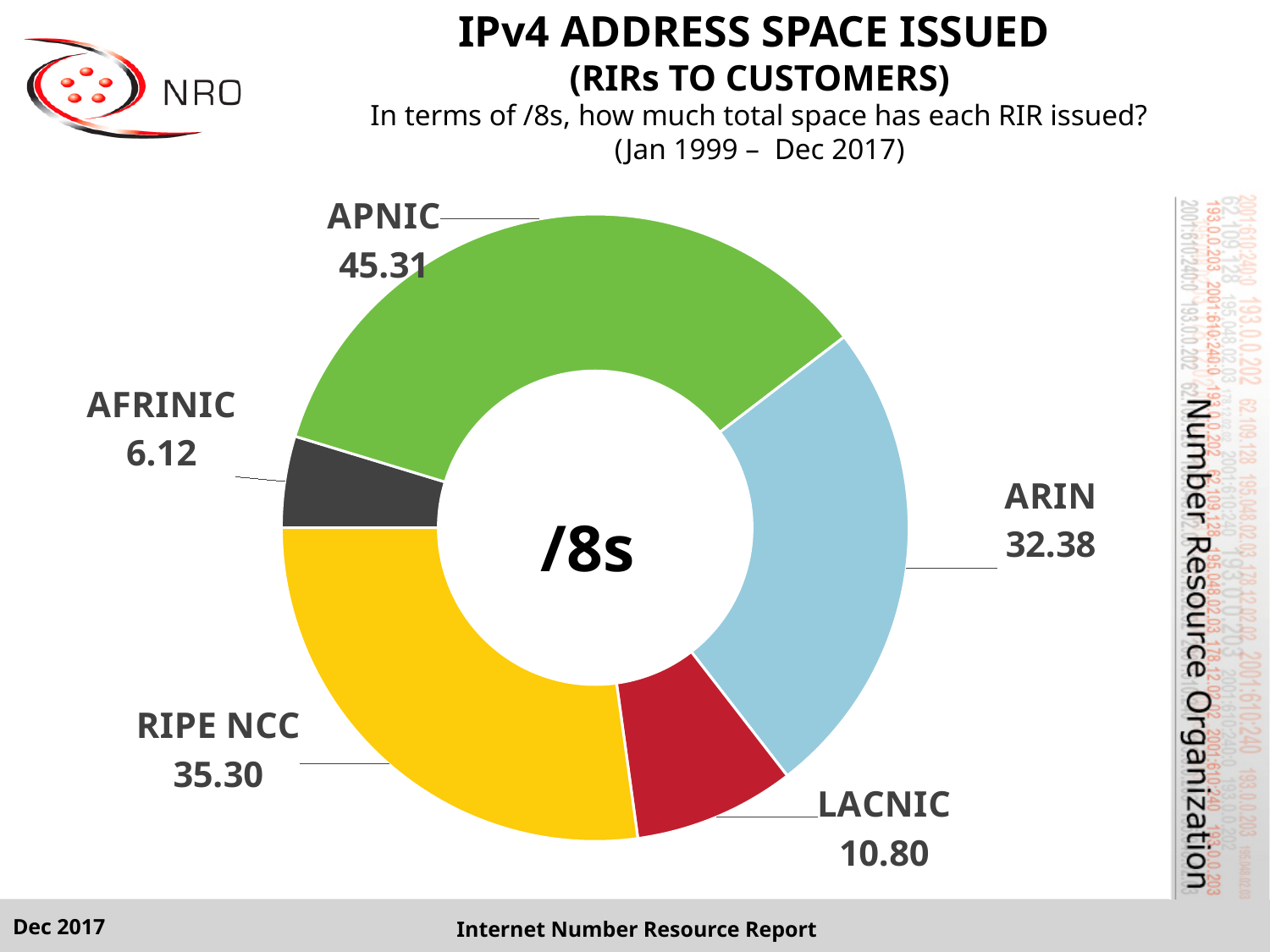
What value is shown for APNIC in the pie chart? 45.31 What unit label is printed in the centre of the chart? /8s What value is shown for LACNIC? 10.80 What is the difference between the values for APNIC and ARIN? 12.93 Which RIR has the largest slice of the chart? APNIC How many RIRs are shown as slices in the chart? 5 What kind of chart is shown on the slide? doughnut chart Which is larger, the value for ARIN or the value for RIPE NCC? RIPE NCC What is the difference between the values for RIPE NCC and LACNIC? 24.50 What value is shown for RIPE NCC? 35.30 What value is shown for AFRINIC? 6.12 Which RIR has the smallest slice of the chart? AFRINIC